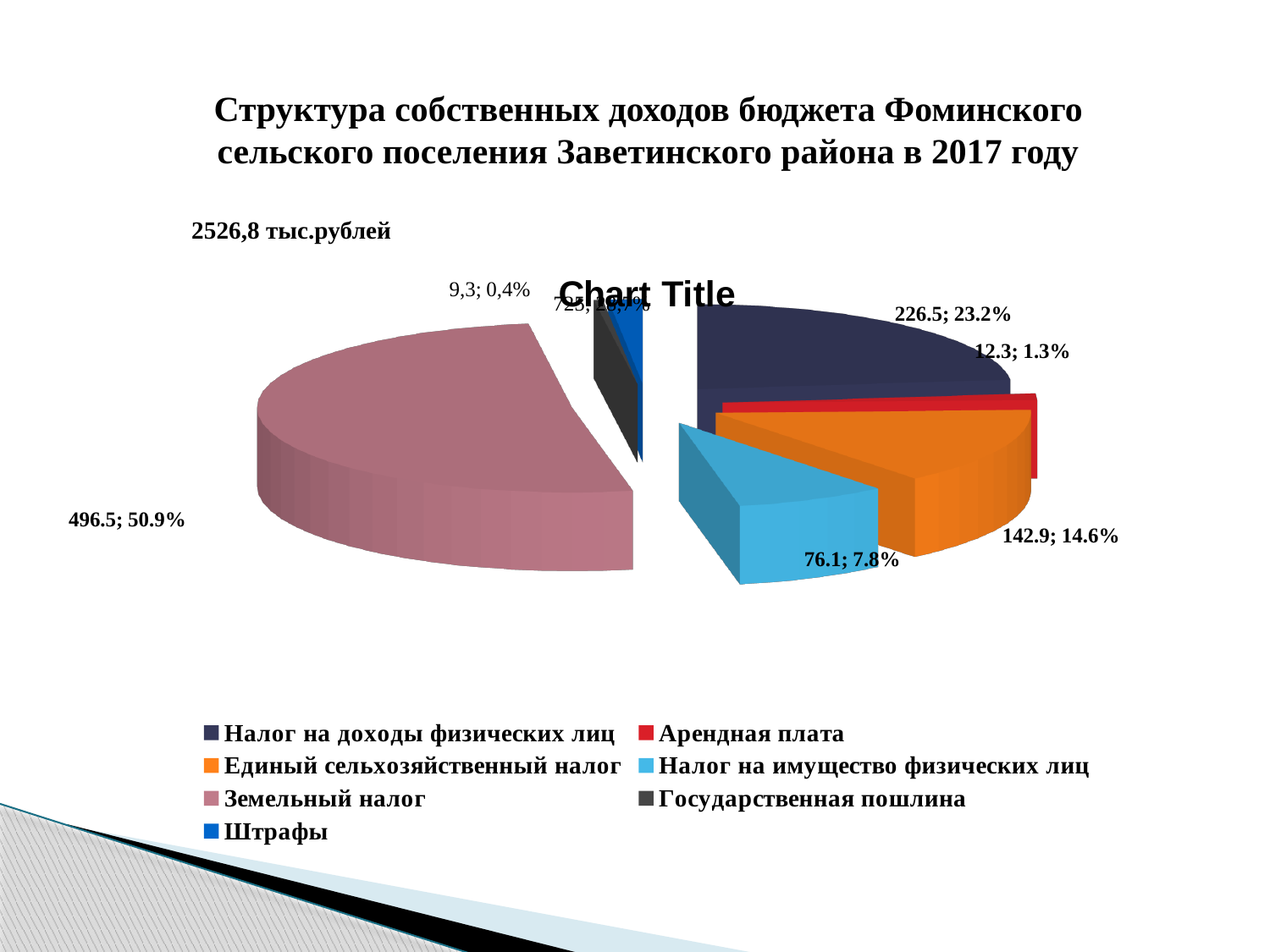
What is the difference between the values for Налог на доходы физических лиц and Единый сельхозяйственный налог? 83.6 Which category has the largest slice of the pie? Земельный налог What value and share are shown for Налог на имущество физических лиц? 76.1; 7.8% What kind of chart is shown on the slide? pie chart What value and share are shown for Земельный налог? 496.5; 50.9% What value and share are shown for Единый сельхозяйственный налог? 142.9; 14.6% What value and share are shown for Налог на доходы физических лиц? 226.5; 23.2% What share of the pie does Земельный налог take? 50.9% What value and share are shown for Арендная плата? 12.3; 1.3% Which is larger, Единый сельхозяйственный налог or Налог на имущество физических лиц? Единый сельхозяйственный налог How many entries does the legend of the pie chart list? 7 What total amount in thousand rubles is stated above the chart? 2526,8 тыс.рублей